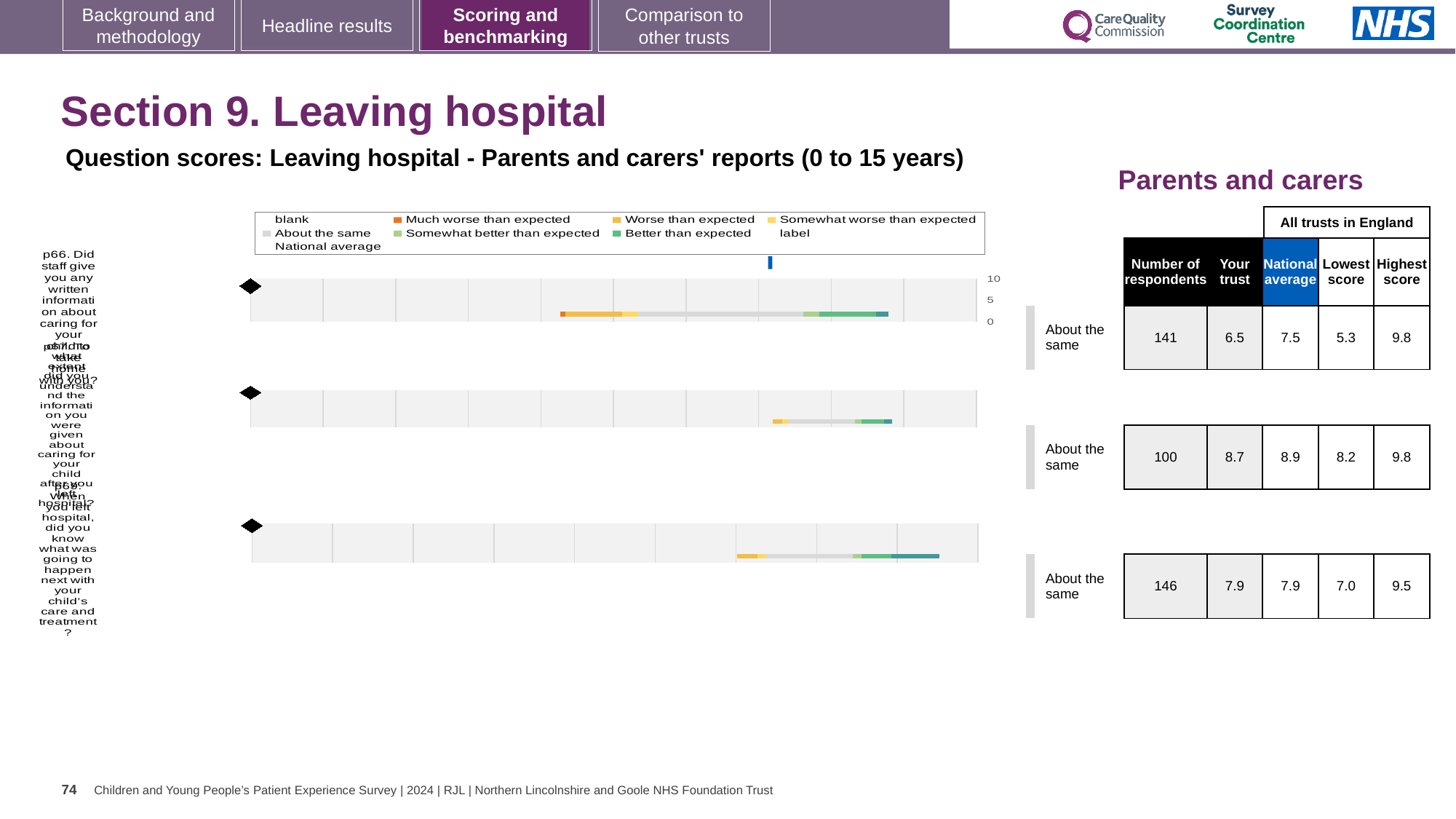
How many questions (rows) are plotted in the question scores chart? 3 What is the lowest 'Lowest score' value shown in the table, and for which question? 5.3, the first (top) question In the table next to the chart, how many respondents are listed for the third (bottom) question? 146 What is the 'Highest score' listed for the third (bottom) question? 9.5 What kind of chart is used to show the question scores on this slide? bar chart For the first (top) question, how much higher is the national average than the 'Your trust' score? 1.0 Which has the larger 'Your trust' score: the second question or the third question? the second question (8.7) What benchmark category is shown for all three questions on this slide? About the same In the table next to the chart, what is the 'Your trust' score for the first (top) question? 6.5 Which of the three questions has the highest 'Your trust' score? the second question (8.7) How many entries does the legend of the question scores chart list? 9 In the table next to the chart, what is the national average for the second question? 8.9